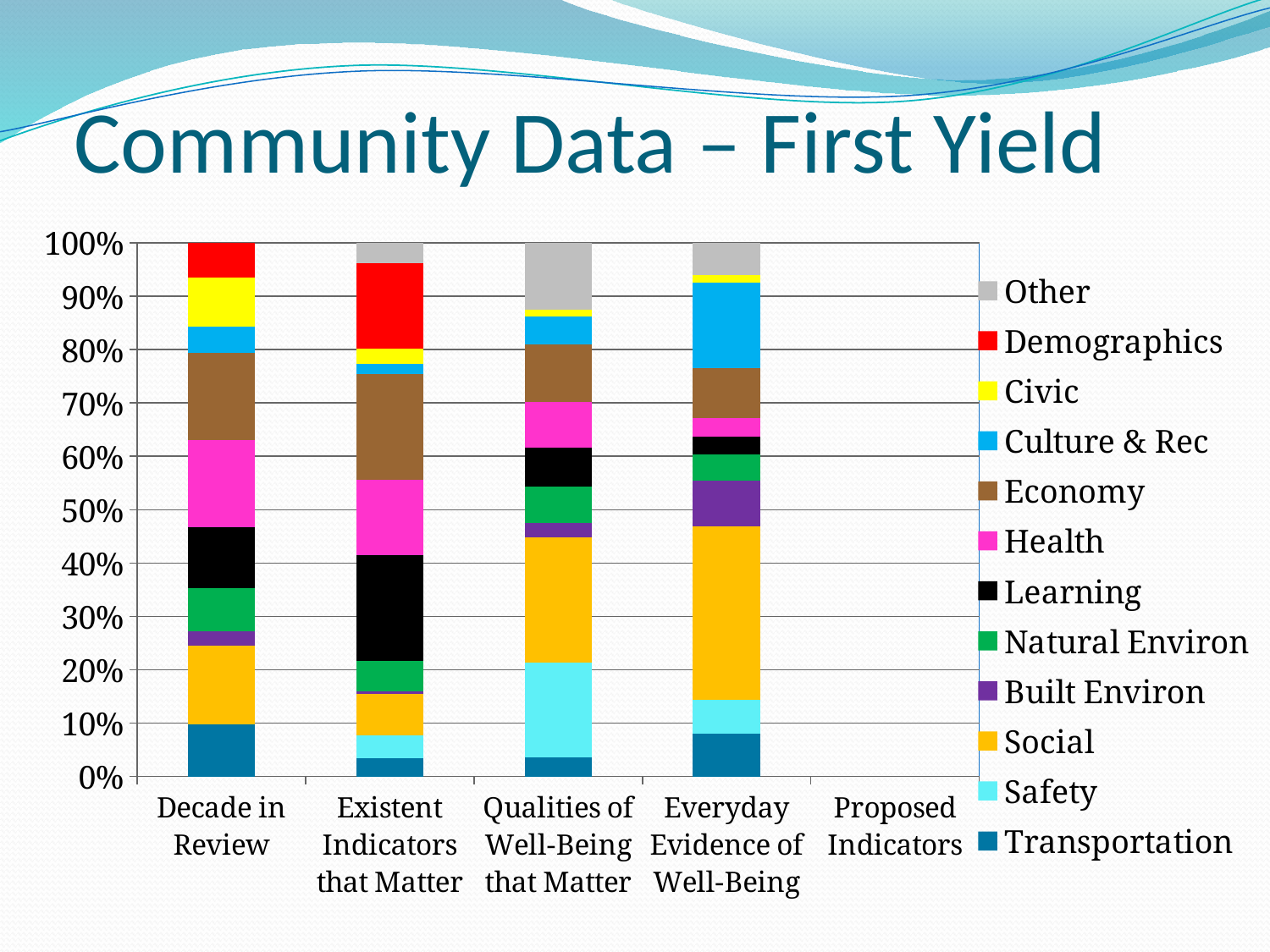
How many series does the legend list? 12 Which category has the largest Safety segment? Qualities of Well-Being that Matter Which category has the largest Other segment? Qualities of Well-Being that Matter How many categories are labelled on the x axis? 5 Is the Safety segment for Qualities of Well-Being that Matter greater or less than 10%? greater Is the Learning segment larger for Existent Indicators that Matter or for Qualities of Well-Being that Matter? Existent Indicators that Matter Which category has the largest Social segment? Everyday Evidence of Well-Being Which x-axis category has no bar plotted? Proposed Indicators What is the title of the slide containing the chart? Community Data – First Yield What kind of chart is shown on the slide? Stacked bar chart Is the Social segment larger for Everyday Evidence of Well-Being or for Decade in Review? Everyday Evidence of Well-Being